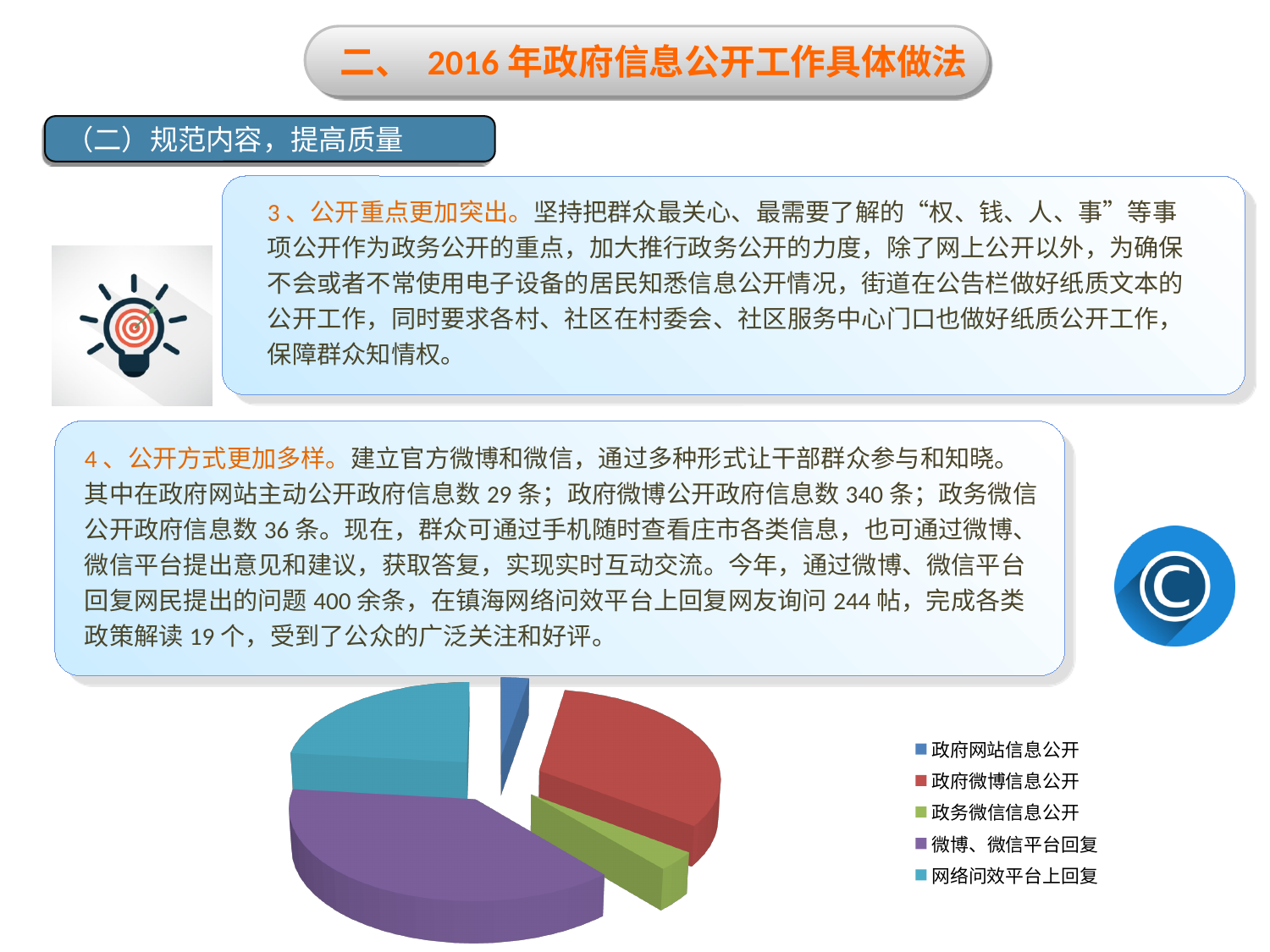
Which slice is larger in the pie chart, 网络问效平台上回复 or 政务微信信息公开? 网络问效平台上回复 Which legend entry is shown in purple in the pie chart? 微博、微信平台回复 Which category has the smallest slice in the pie chart? 政府网站信息公开 How many entries does the legend of the pie chart list? 5 What colour represents 政府微博信息公开 in the pie chart? red Which slice is larger in the pie chart, 政府微博信息公开 or 网络问效平台上回复? 政府微博信息公开 How many slices does the pie chart have? 5 Which category has the largest slice in the pie chart? 微博、微信平台回复 Which slice is larger in the pie chart, 微博、微信平台回复 or 政府微博信息公开? 微博、微信平台回复 What kind of chart is shown at the bottom of the slide? pie chart